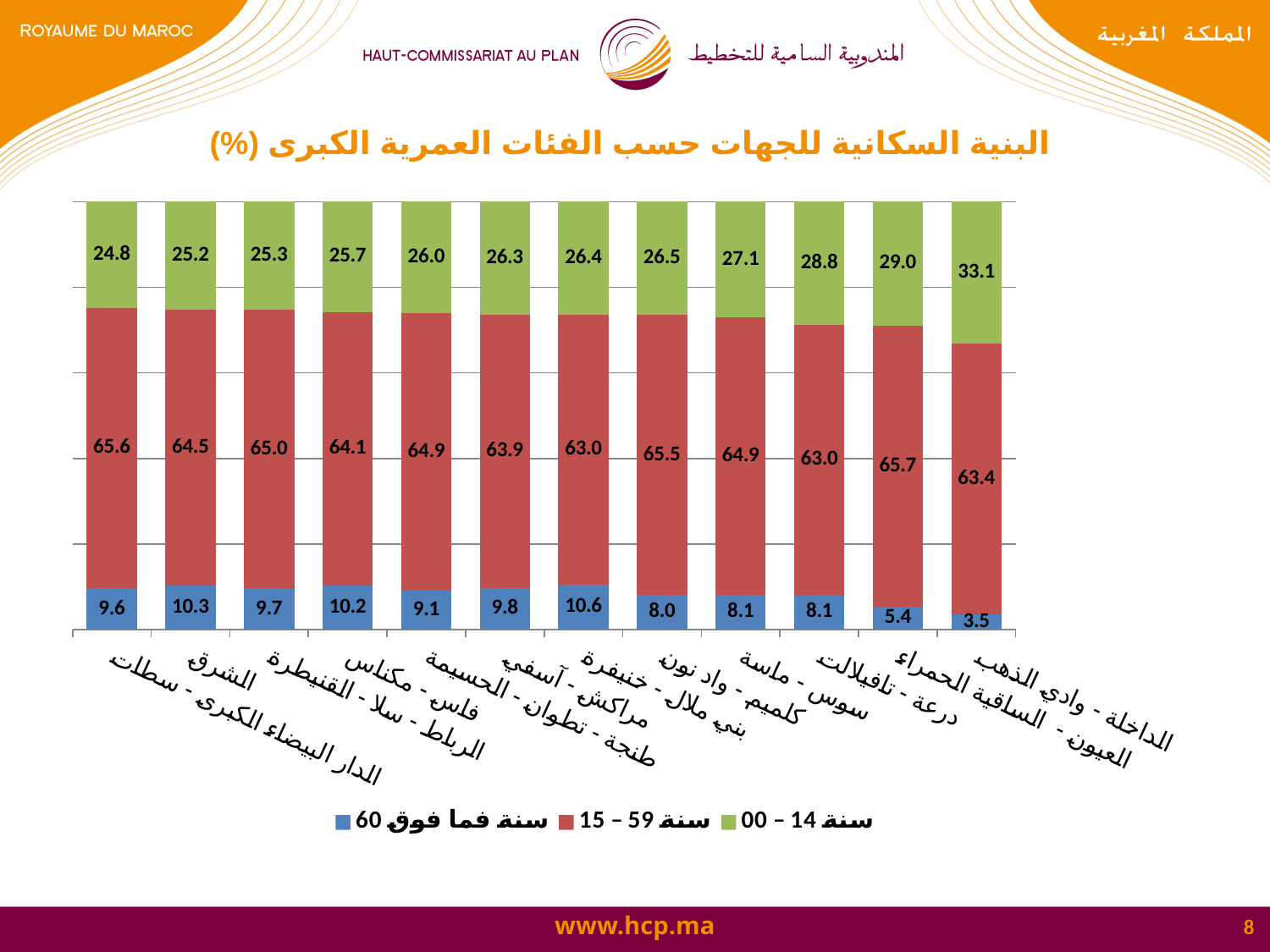
What is the value of the '00 – 14 سنة' series for الداخلة - وادي الذهب? 33.1 Which is larger: the '60 سنة فما فوق' value for فاس - مكناس or for سوس - ماسة? فاس - مكناس Which region has the highest value for the '60 سنة فما فوق' series? بني ملال - خنيفرة Which region has the lowest value for the '60 سنة فما فوق' series? الداخلة - وادي الذهب What is the total of the stacked bar for الدار البيضاء - سطات? 100.0 What is the value of the '15 – 59 سنة' series for العيون - الساقية الحمراء? 65.7 What is the difference between the '00 – 14 سنة' values for الداخلة - وادي الذهب and الدار البيضاء - سطات? 8.3 How many series does the legend list? 3 What type of chart is shown on the slide? stacked bar chart What is the value of the '60 سنة فما فوق' series for الشرق? 10.3 How many regions (categories) are shown on the x axis of the chart? 12 Which region has the highest value for the '00 – 14 سنة' series? الداخلة - وادي الذهب